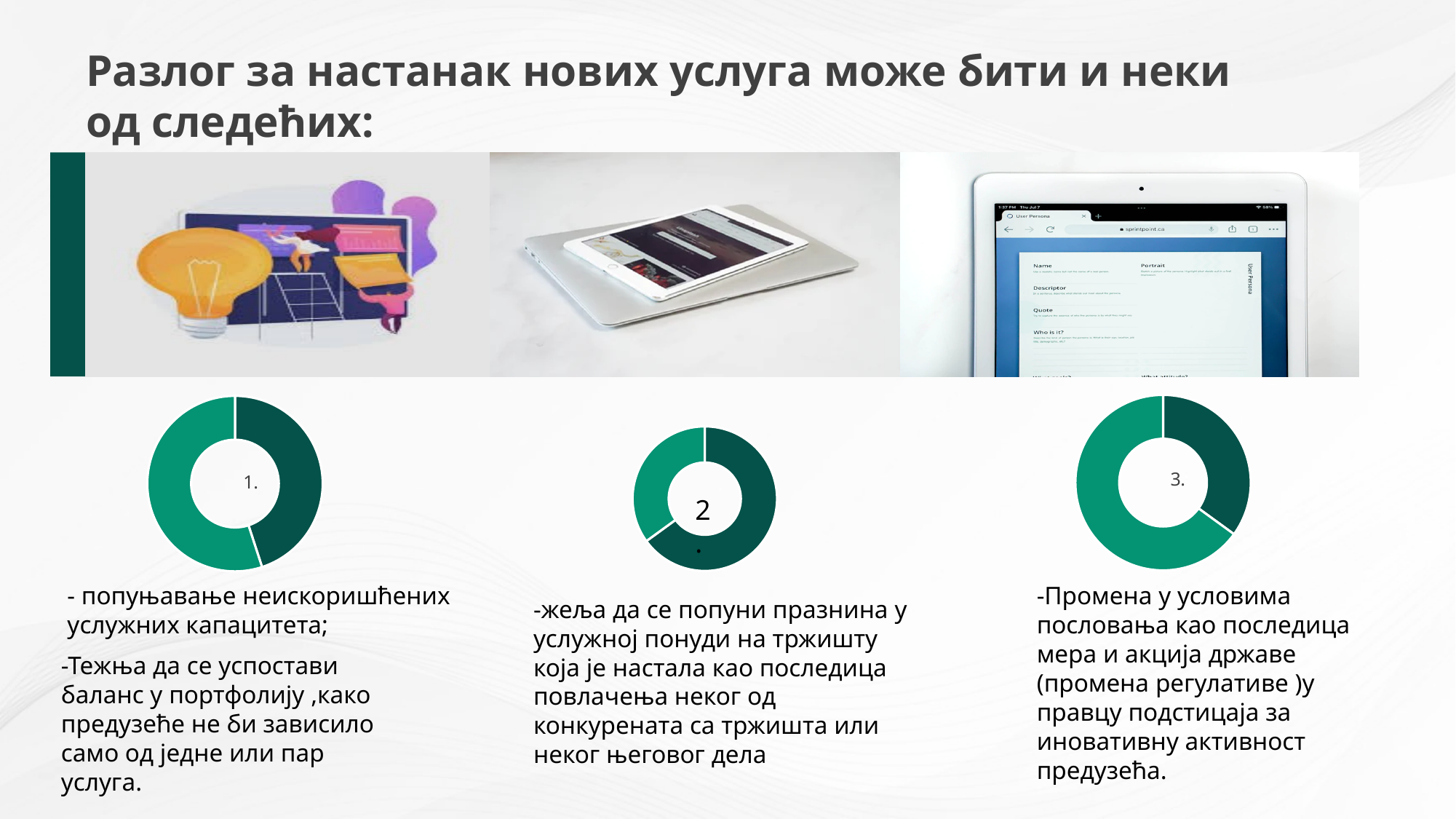
What kind of chart is the chart labelled "1." on the left of the slide? doughnut (pie) chart What label is printed in the centre of the right-hand doughnut chart? 3. In the chart labelled "3." on the right of the slide, which slice is larger, the dark green one or the light green one? the light green one How many slices does the chart labelled "1." on the left of the slide have? 2 How many doughnut charts are shown on the slide? 3 What label is printed in the centre of the left-hand doughnut chart? 1. What kind of chart is the chart labelled "3." on the right of the slide? doughnut (pie) chart In the chart labelled "2" in the middle of the slide, which slice is larger, the dark green one or the light green one? the dark green one How many slices does the chart labelled "2" in the middle of the slide have? 2